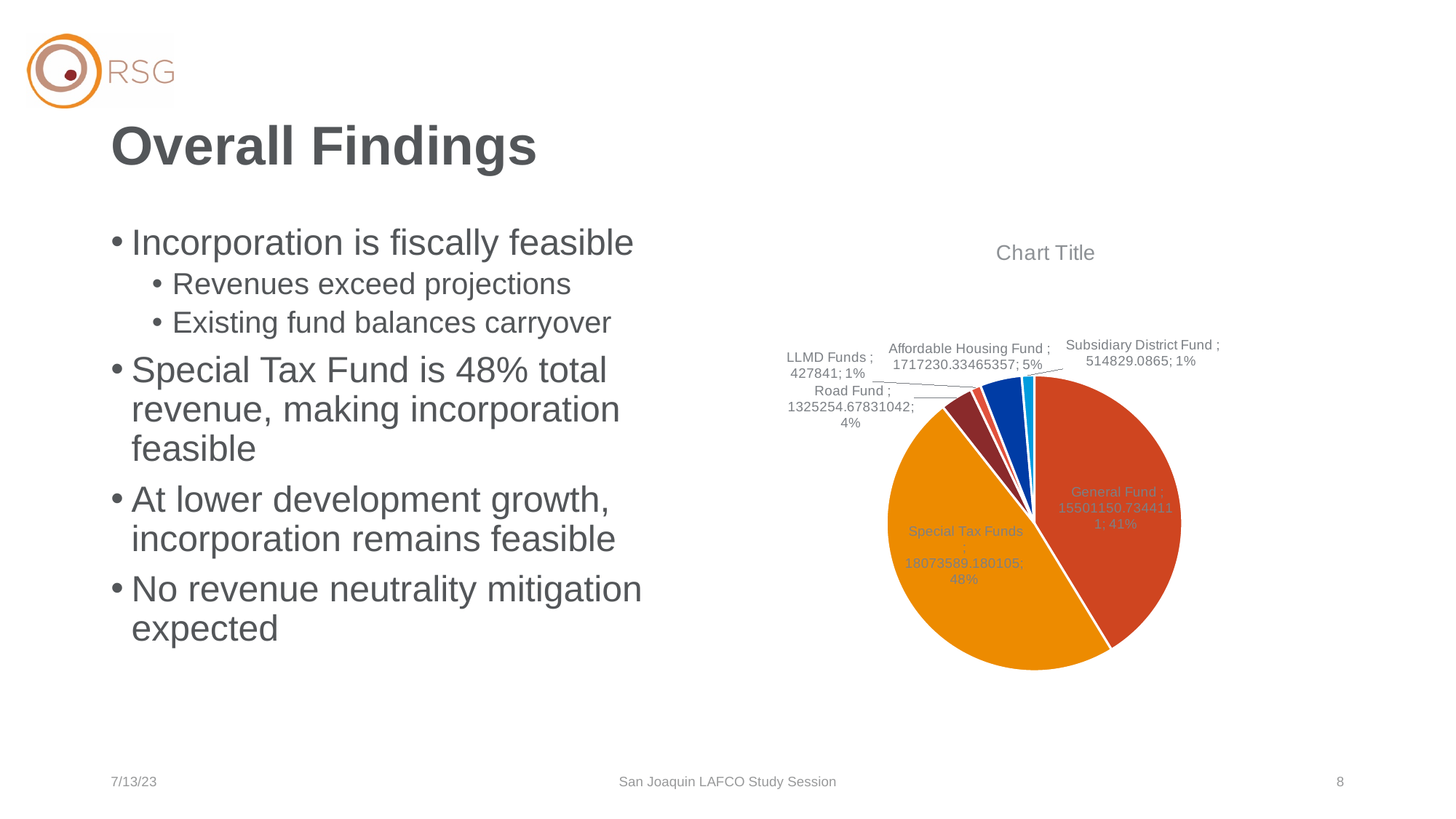
How many slices does the pie chart have? 6 What is the title of the chart? Chart Title What share of the pie does the General Fund represent? 41% What is the value shown for the Subsidiary District Fund? 514829.0865 What is the value shown for LLMD Funds? 427841 Which is larger, the Road Fund slice or the Affordable Housing Fund slice? Affordable Housing Fund Which slice of the pie chart has the smallest value? LLMD Funds What kind of chart is shown on the slide? pie chart What share of the pie does Special Tax Funds represent? 48% What share of the pie does the Road Fund represent? 4% What is the difference in percentage points between the Special Tax Funds share and the General Fund share? 7 percentage points Which slice of the pie chart is the largest? Special Tax Funds